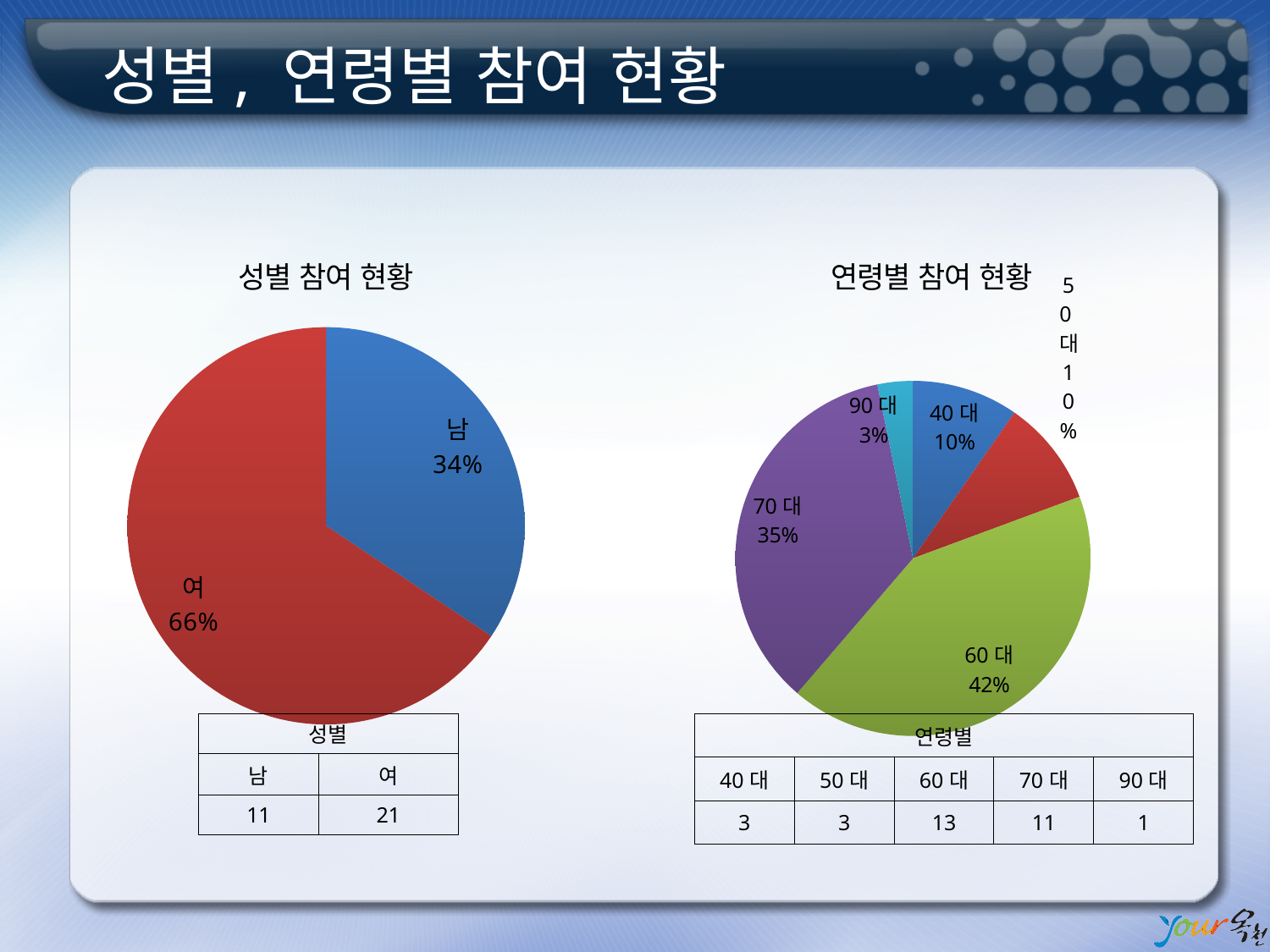
In the '연령별 참여 현황' chart, which is larger, the slice for 70 대 or the slice for 40 대? 70 대 In the '성별 참여 현황' chart, which category has the larger slice? 여 In the '연령별 참여 현황' chart, what share of the pie does 60 대 represent? 42% In the '연령별 참여 현황' chart, which age group has the smallest slice? 90 대 In the '성별 참여 현황' chart, what share of the pie does 여 represent? 66% How many age groups are shown in the '연령별 참여 현황' chart? 5 According to the table under the '연령별 참여 현황' chart, what is the value for 70 대? 11 What kind of chart is the '연령별 참여 현황' chart? Pie chart According to the table under the '성별 참여 현황' chart, what is the value for 남? 11 In the '성별 참여 현황' chart, what share of the pie does 남 represent? 34% In the '연령별 참여 현황' chart, which age group has the largest slice? 60 대 According to the table under the '성별 참여 현황' chart, what is the difference between the values for 여 and 남? 10